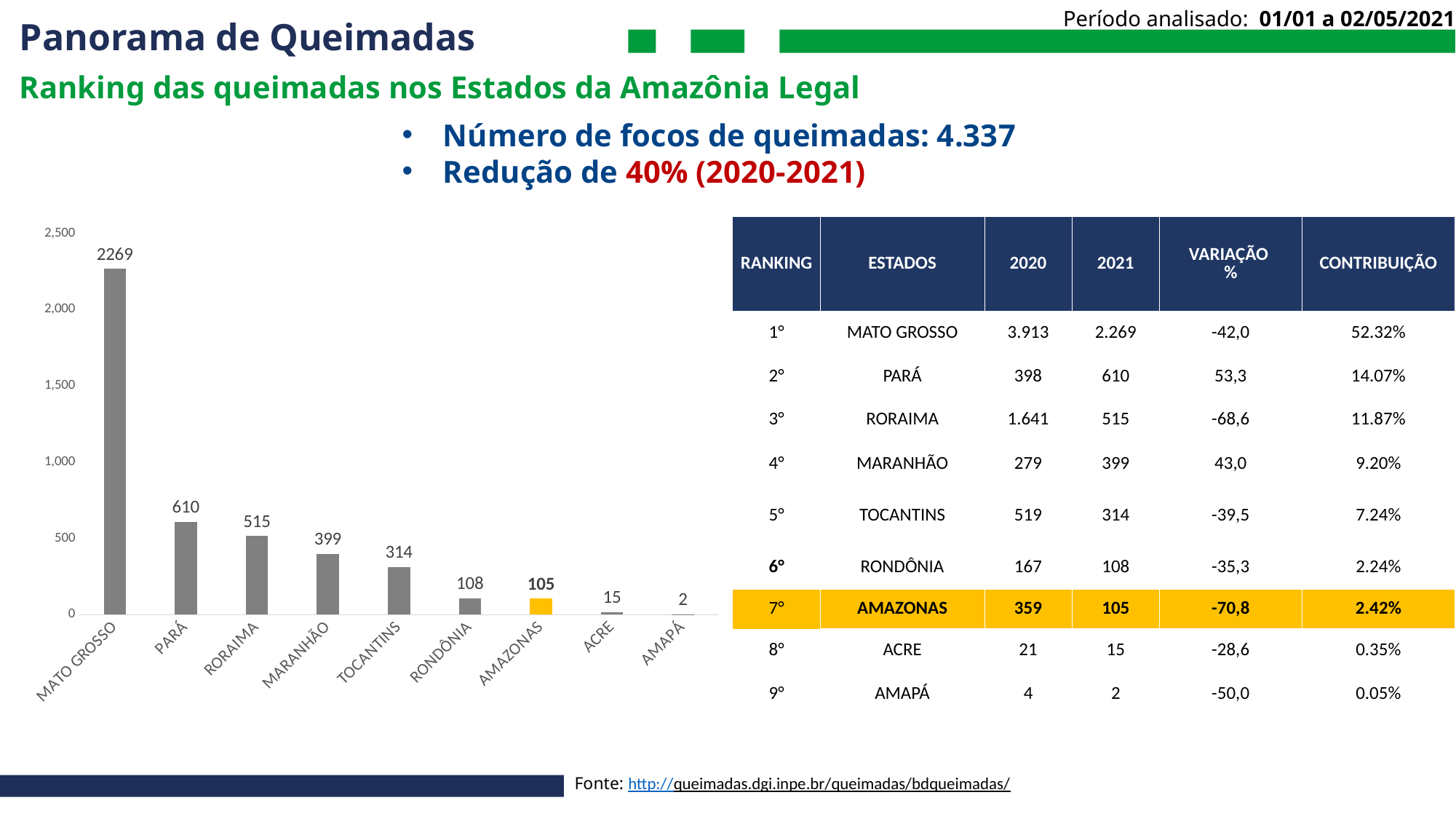
Which state has the lowest bar in the chart? AMAPÁ Which has a larger value in the bar chart, TOCANTINS or RONDÔNIA? TOCANTINS How many states are shown on the x axis of the bar chart? 9 Is the value for PARÁ in the bar chart greater or less than 500? greater What is the difference between the values for PARÁ and RORAIMA in the bar chart? 95 Which state's bar is highlighted in yellow in the chart? AMAZONAS What is the value shown for RORAIMA in the bar chart? 515 What is the difference between the values for MARANHÃO and TOCANTINS in the bar chart? 85 What type of chart is shown on the left of the slide? Bar chart Which state has the highest bar in the chart? MATO GROSSO What is the value shown for AMAZONAS in the bar chart? 105 What is the value shown for MATO GROSSO in the bar chart? 2269